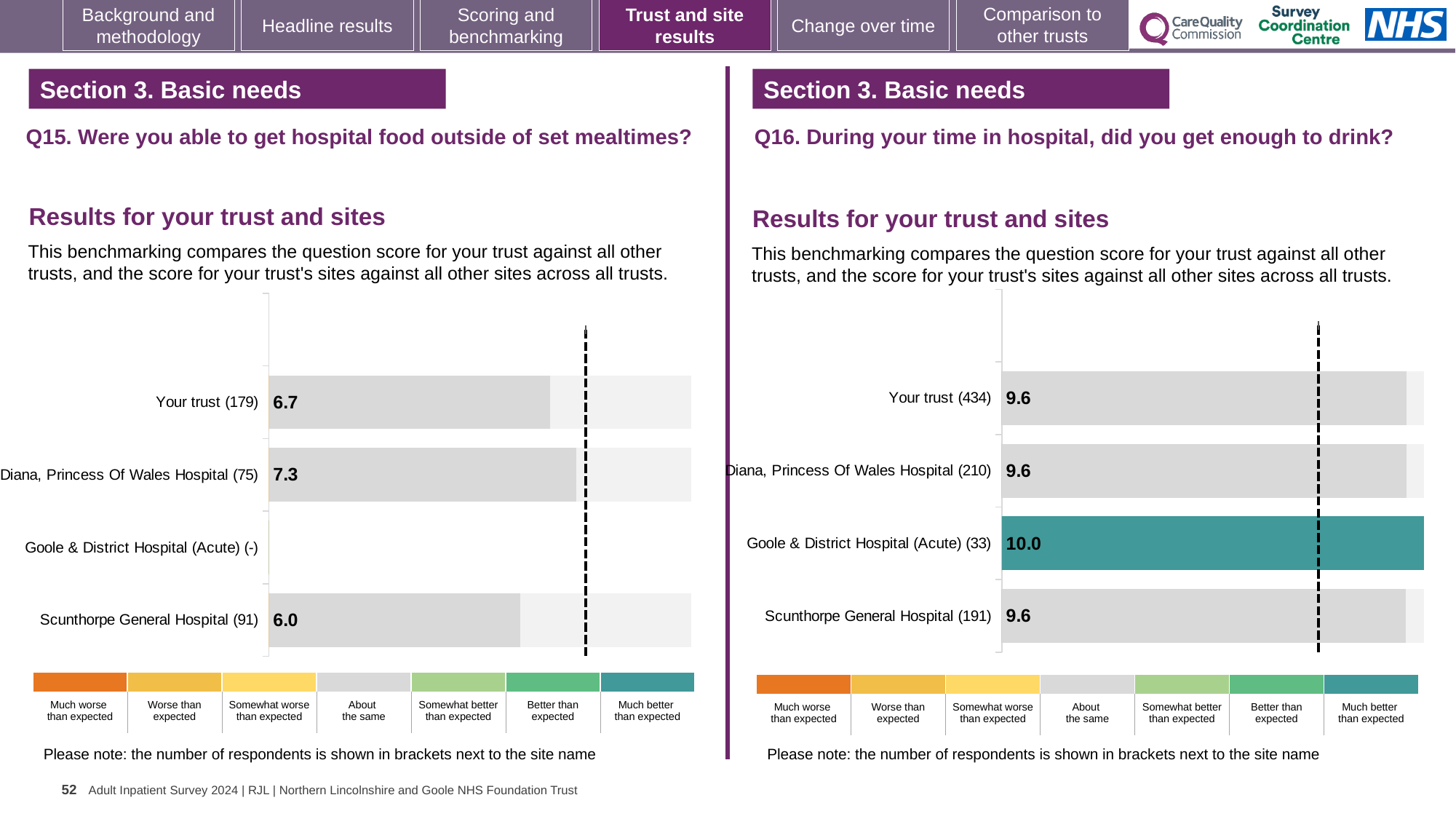
On the Q16 chart (right), what is the score for Goole & District Hospital (Acute)? 10.0 On the Q15 chart (left), what is the score for Your trust? 6.7 On the Q15 chart (left), which is larger: the score for Your trust or the score for Scunthorpe General Hospital? Your trust On the Q15 chart (left), which site has the highest score? Diana, Princess Of Wales Hospital On the Q16 chart (right), which site has the highest score? Goole & District Hospital (Acute) What kind of chart is used on the Q16 chart (right)? Bar chart On the Q15 chart (left), what is the difference between the scores for Diana, Princess Of Wales Hospital and Scunthorpe General Hospital? 1.3 On the Q16 chart (right), how many respondents are shown in brackets for Your trust? 434 On the Q15 chart (left), what is the score for Diana, Princess Of Wales Hospital? 7.3 On the Q16 chart (right), what is the score for Your trust? 9.6 On the Q16 chart (right), what is the difference between the scores for Goole & District Hospital (Acute) and Scunthorpe General Hospital? 0.4 On the Q15 chart (left), what is the score for Scunthorpe General Hospital? 6.0